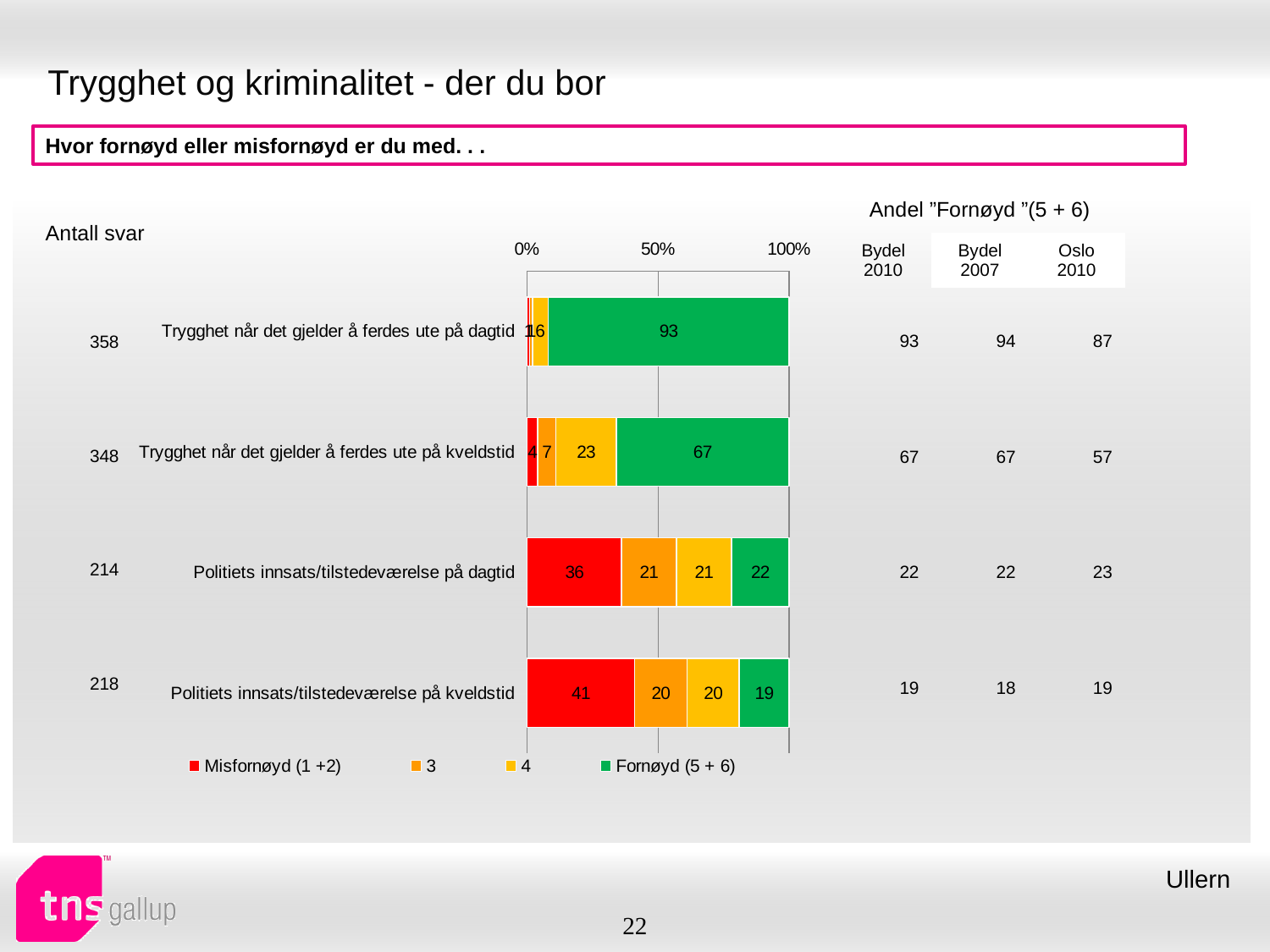
Which category has the highest Fornøyd (5 + 6) value? Trygghet når det gjelder å ferdes ute på dagtid Which category has the lowest Fornøyd (5 + 6) value? Politiets innsats/tilstedeværelse på kveldstid How many categories are plotted in the chart? 4 What is the value of Fornøyd (5 + 6) for "Trygghet når det gjelder å ferdes ute på dagtid"? 93 What is the value of series 3 for "Politiets innsats/tilstedeværelse på dagtid"? 21 Which has the larger Fornøyd (5 + 6) value: "Trygghet når det gjelder å ferdes ute på kveldstid" or "Politiets innsats/tilstedeværelse på dagtid"? Trygghet når det gjelder å ferdes ute på kveldstid What is the value of series 4 for "Trygghet når det gjelder å ferdes ute på kveldstid"? 23 How many series does the chart legend list? 4 What is the value of Misfornøyd (1 +2) for "Politiets innsats/tilstedeværelse på kveldstid"? 41 What colour represents Fornøyd (5 + 6) in the chart? green What kind of chart is shown on the slide? bar chart What is the difference between the Misfornøyd (1 +2) values for "Politiets innsats/tilstedeværelse på kveldstid" and "Politiets innsats/tilstedeværelse på dagtid"? 5